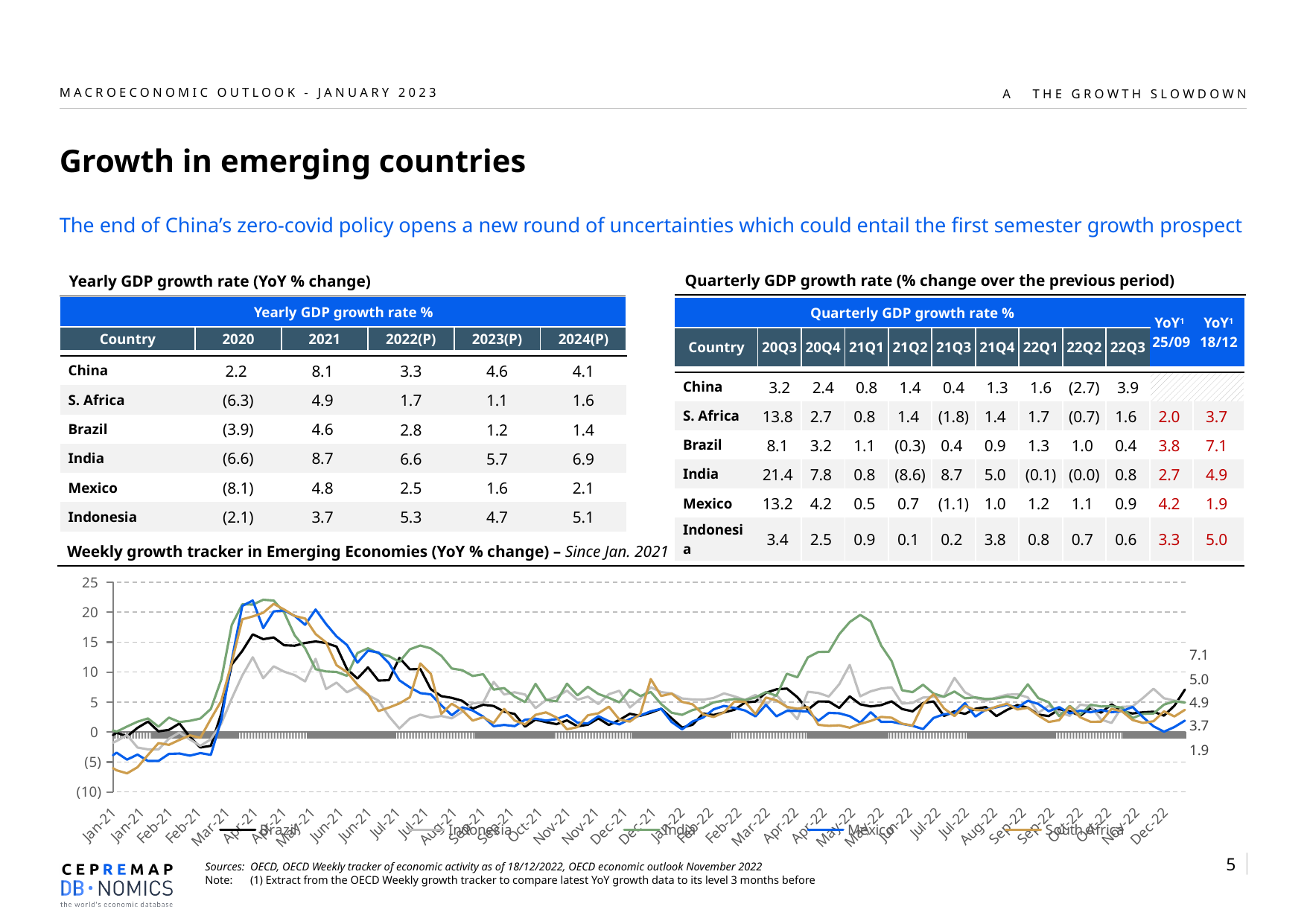
In the weekly growth tracker chart, is India's peak around Apr-21 greater or less than 20? greater In the weekly growth tracker chart, is Mexico's value in Jan-21 greater or less than 0? less Which countries are listed in the legend of the weekly growth tracker chart? Brazil, Indonesia, India, Mexico, South Africa What is the highest value printed at the right end of the weekly growth tracker chart? 7.1 What is the lowest value printed at the right end of the weekly growth tracker chart? 1.9 What kind of chart is the 'Weekly growth tracker in Emerging Economies' chart? line chart In the weekly growth tracker chart, which series reaches the highest value around May-22? India In the weekly growth tracker chart, is India's peak around May-22 greater or less than 15? greater In the weekly growth tracker chart, does India's line rise or fall between May-22 and Jul-22? fall What is the highest value shown on the y axis of the weekly growth tracker chart? 25 How many series does the legend of the weekly growth tracker chart list? 5